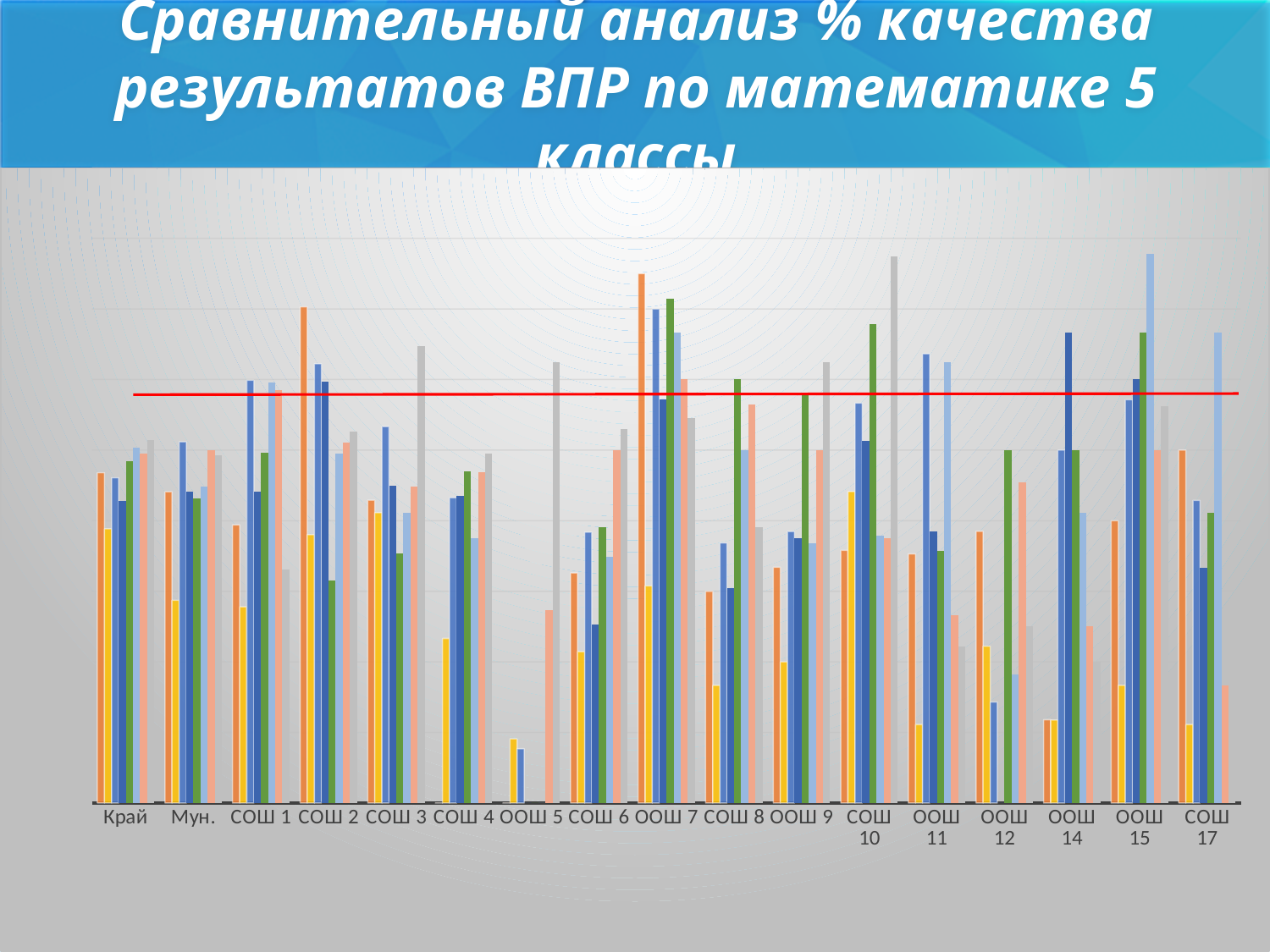
What is the title of the slide containing the chart? Сравнительный анализ % качества результатов ВПР по математике 5 классы Which category has the shortest yellow bar? ООШ 5 Is the yellow bar taller for СОШ 10 or for ООШ 14? СОШ 10 How many categories are shown along the x axis of the chart? 17 Which category has the tallest orange bar? ООШ 7 What is the last category label on the x axis? СОШ 17 What is the first category label on the x axis? Край What kind of chart is shown on the slide? bar chart Is the orange bar taller for ООШ 7 or for Край? ООШ 7 What colour is the horizontal reference line drawn across the chart? red Is the orange bar taller for СОШ 2 or for ООШ 14? СОШ 2 Which category has the tallest yellow bar? СОШ 10